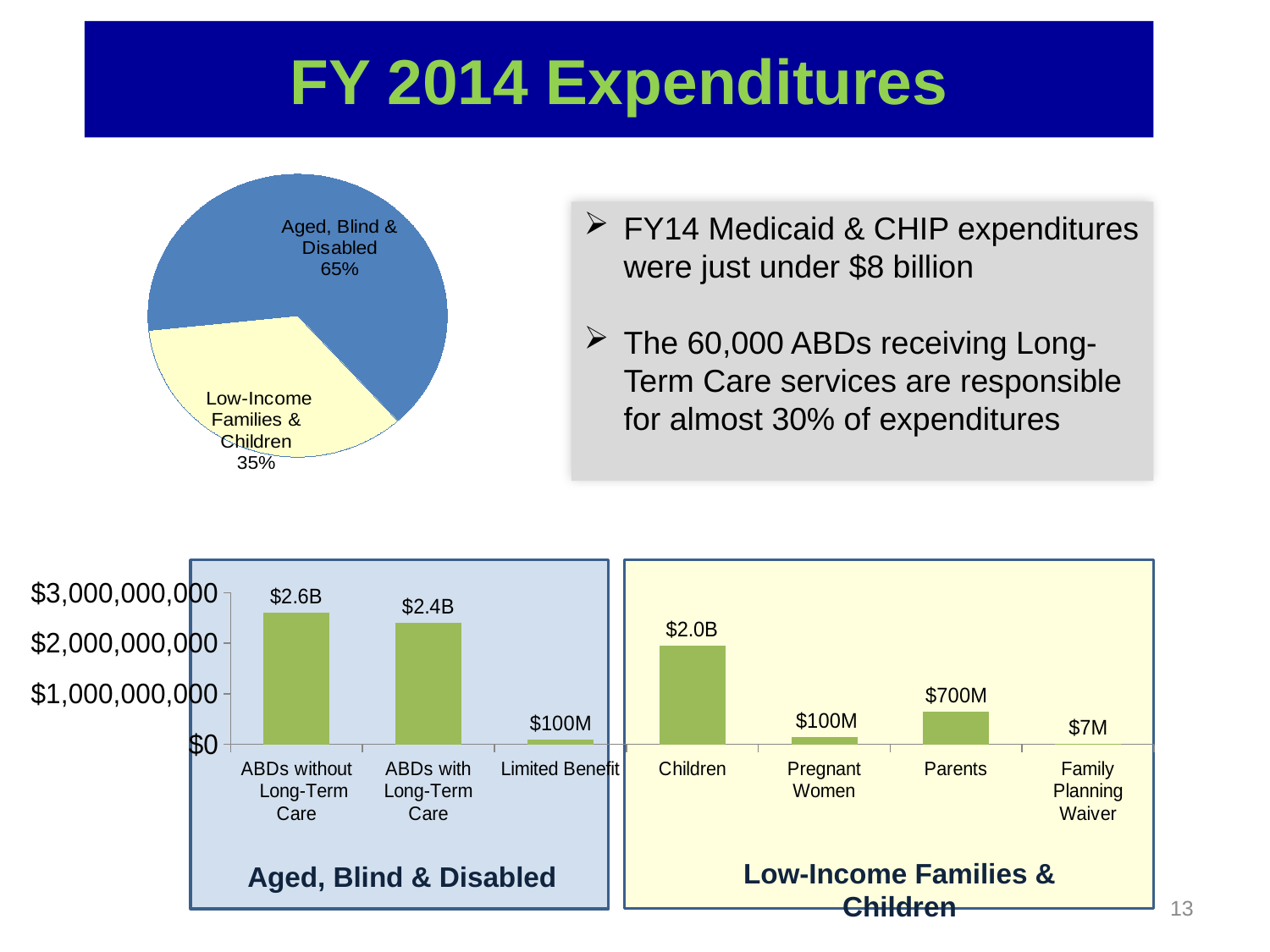
In the bottom bar chart, what is the value for Family Planning Waiver? $7M In the bottom bar chart, what is the value for Parents? $700M In the bottom bar chart, which category has the highest value? ABDs without Long-Term Care In the bottom bar chart, which category has the lowest value? Family Planning Waiver In the pie chart, what share of expenditures goes to Low-Income Families & Children? 35% How many categories are shown in the bottom bar chart? 7 In the bottom bar chart, what is the value for Children? $2.0B In the pie chart, what share of expenditures goes to Aged, Blind & Disabled? 65% In the bottom bar chart, is the value for Parents greater or less than $1,000,000,000? less In the pie chart, which slice is larger: Aged, Blind & Disabled or Low-Income Families & Children? Aged, Blind & Disabled In the bottom bar chart, what is the difference between ABDs without Long-Term Care and ABDs with Long-Term Care? $0.2B In the bottom bar chart, what is the value for ABDs without Long-Term Care? $2.6B